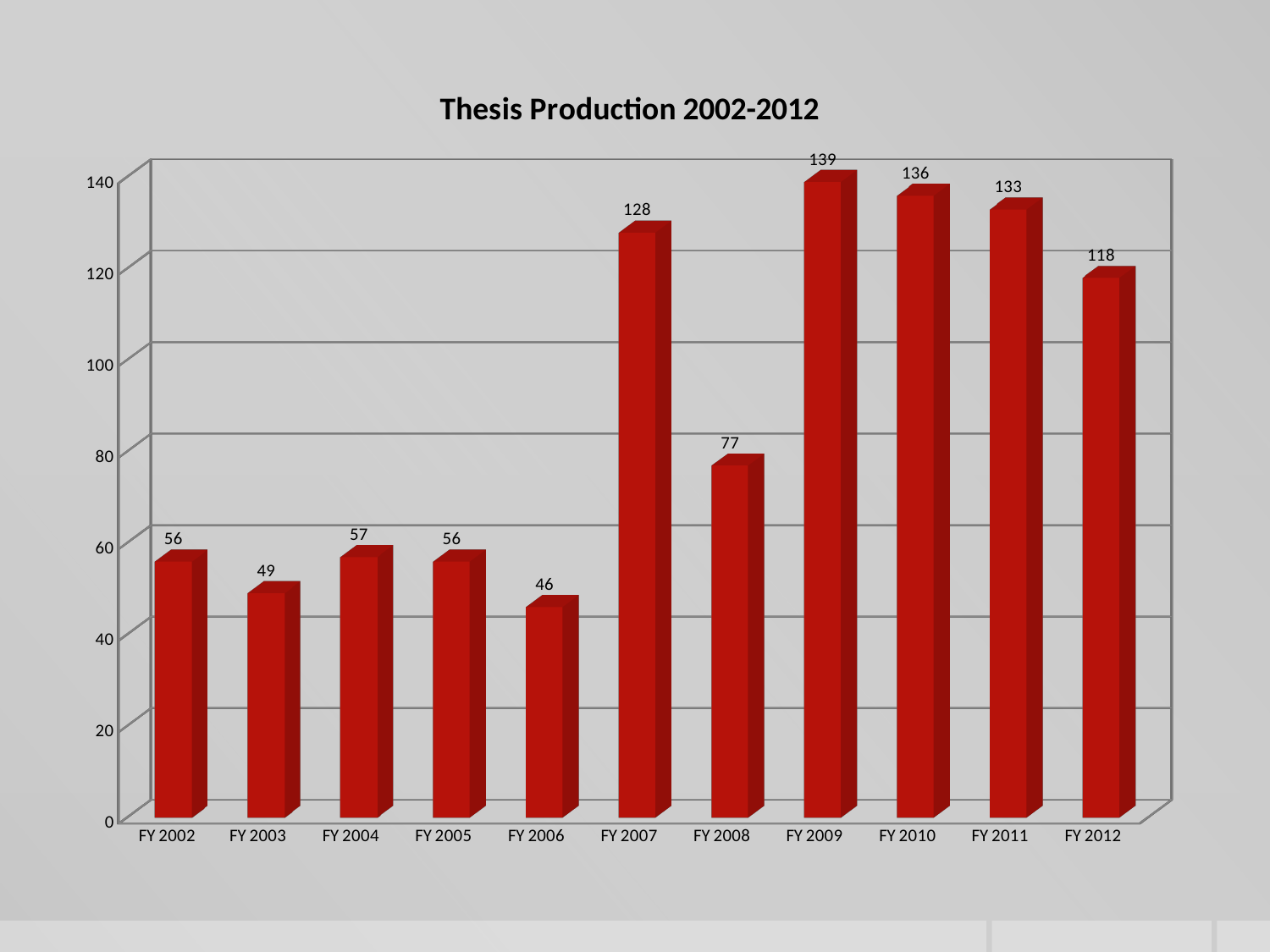
Is the value for FY 2008 greater or less than 80? less Which is larger, the value for FY 2010 or the value for FY 2011? FY 2010 What is the title of the chart? Thesis Production 2002-2012 What kind of chart is shown on the slide? bar chart Which fiscal year has the lowest value? FY 2006 How many fiscal years are shown on the x axis? 11 What is the value for FY 2007? 128 What is the difference between the values for FY 2009 and FY 2008? 62 Do the values rise or fall from FY 2009 to FY 2012? fall What colour are the bars in the chart? red What is the value for FY 2012? 118 Which fiscal year has the highest value? FY 2009